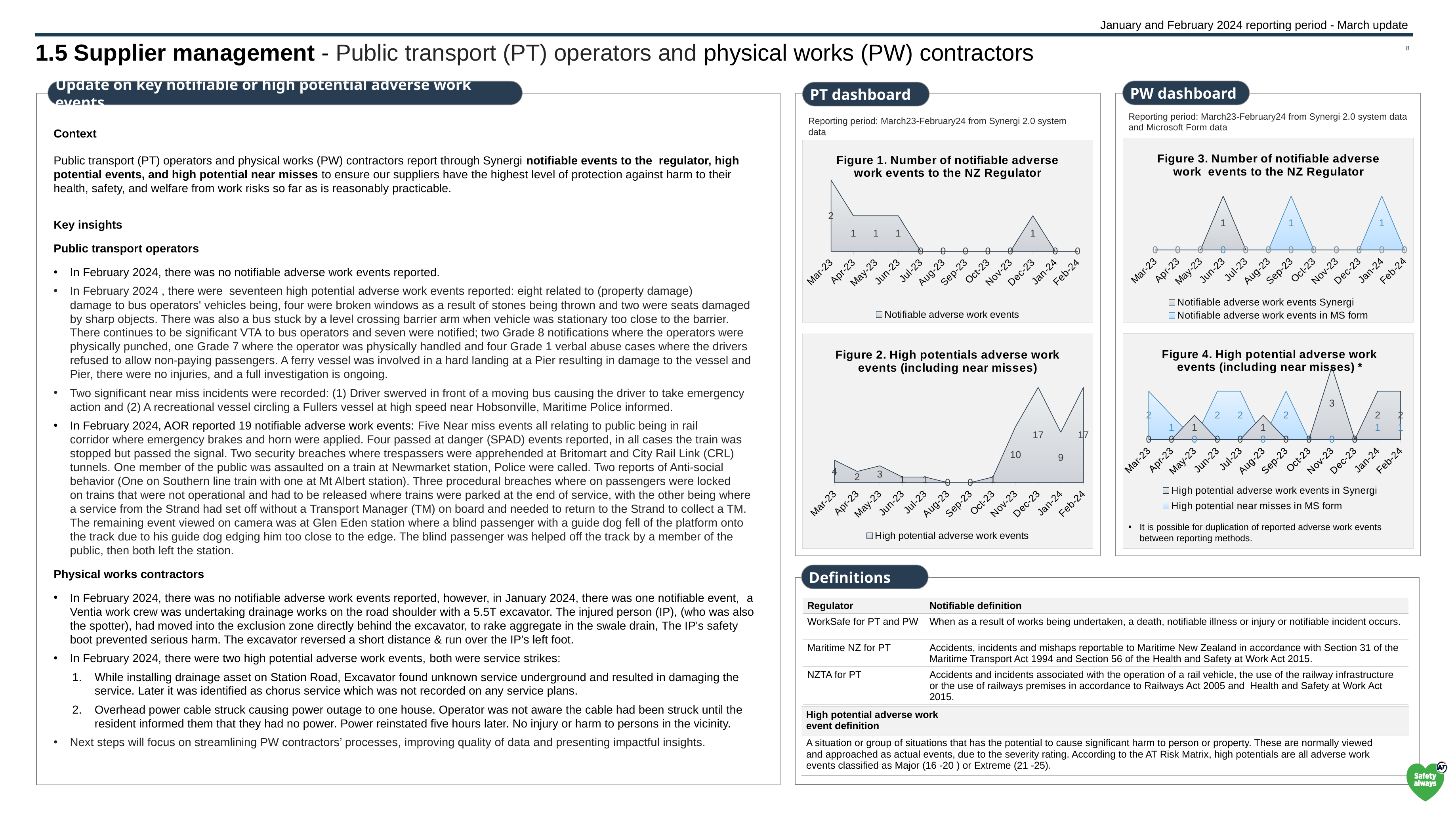
In Figure 4 (PW high potential adverse work events), what is the value for High potential adverse work events in Synergi in Nov-23? 3 In Figure 3 (PW notifiable adverse work events), what is the value for Notifiable adverse work events Synergi in Jun-23? 1 In Figure 1 (Number of notifiable adverse work events to the NZ Regulator), what is the value for Dec-23? 1 In Figure 1 (Number of notifiable adverse work events to the NZ Regulator), which month has the highest value? Mar-23 In Figure 2 (High potentials adverse work events), what is the value for Feb-24? 17 In Figure 1 (Number of notifiable adverse work events to the NZ Regulator), what is the value for Mar-23? 2 In Figure 3 (PW notifiable adverse work events), how many series does the legend list? 2 In Figure 2 (High potentials adverse work events), what is the value for Jan-24? 9 In Figure 1 (Number of notifiable adverse work events to the NZ Regulator), how many months are shown on the x axis? 12 In Figure 2 (High potentials adverse work events), which is larger, the value for May-23 or the value for Apr-23? May-23 In Figure 2 (High potentials adverse work events), what is the value for Mar-23? 4 In Figure 2 (High potentials adverse work events), what is the difference between the values for Dec-23 and Jan-24? 8